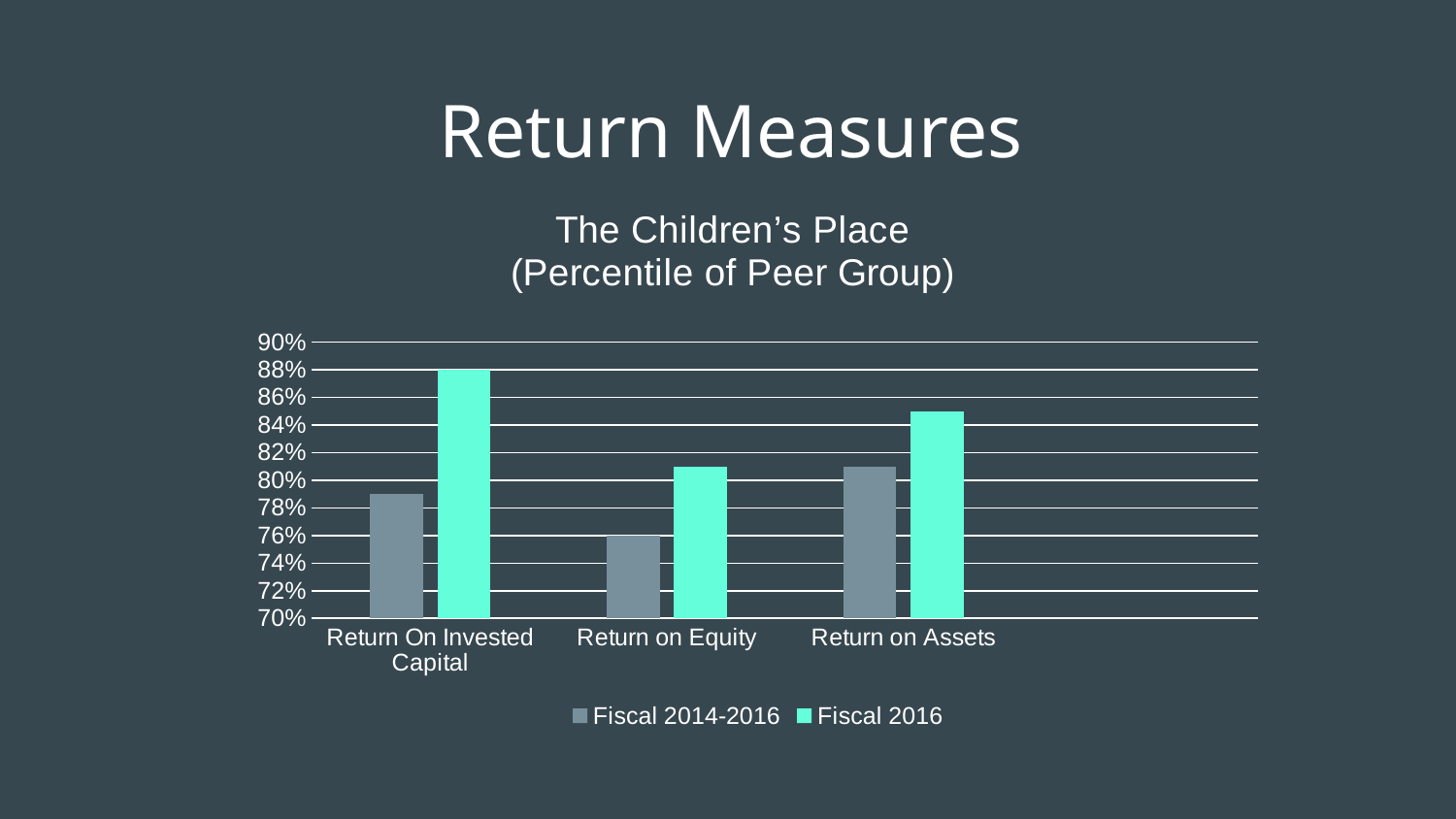
How many categories are shown on the x axis? 3 Is the Fiscal 2016 value for Return on Assets greater or less than 84%? greater Which is larger for Fiscal 2016: Return On Invested Capital or Return on Assets? Return On Invested Capital What kind of chart is shown on the slide? bar chart Which colour represents the Fiscal 2016 series in the legend? teal (bright green) What is the Fiscal 2014-2016 value for Return on Equity? 76% How many series does the legend list? 2 Is the Fiscal 2014-2016 value for Return on Assets greater or less than 80%? greater Which category has the lowest Fiscal 2014-2016 value? Return on Equity What is the Fiscal 2016 value for Return On Invested Capital? 88% Which category has the highest Fiscal 2016 value? Return On Invested Capital Is the Fiscal 2014-2016 value for Return On Invested Capital greater or less than 80%? less